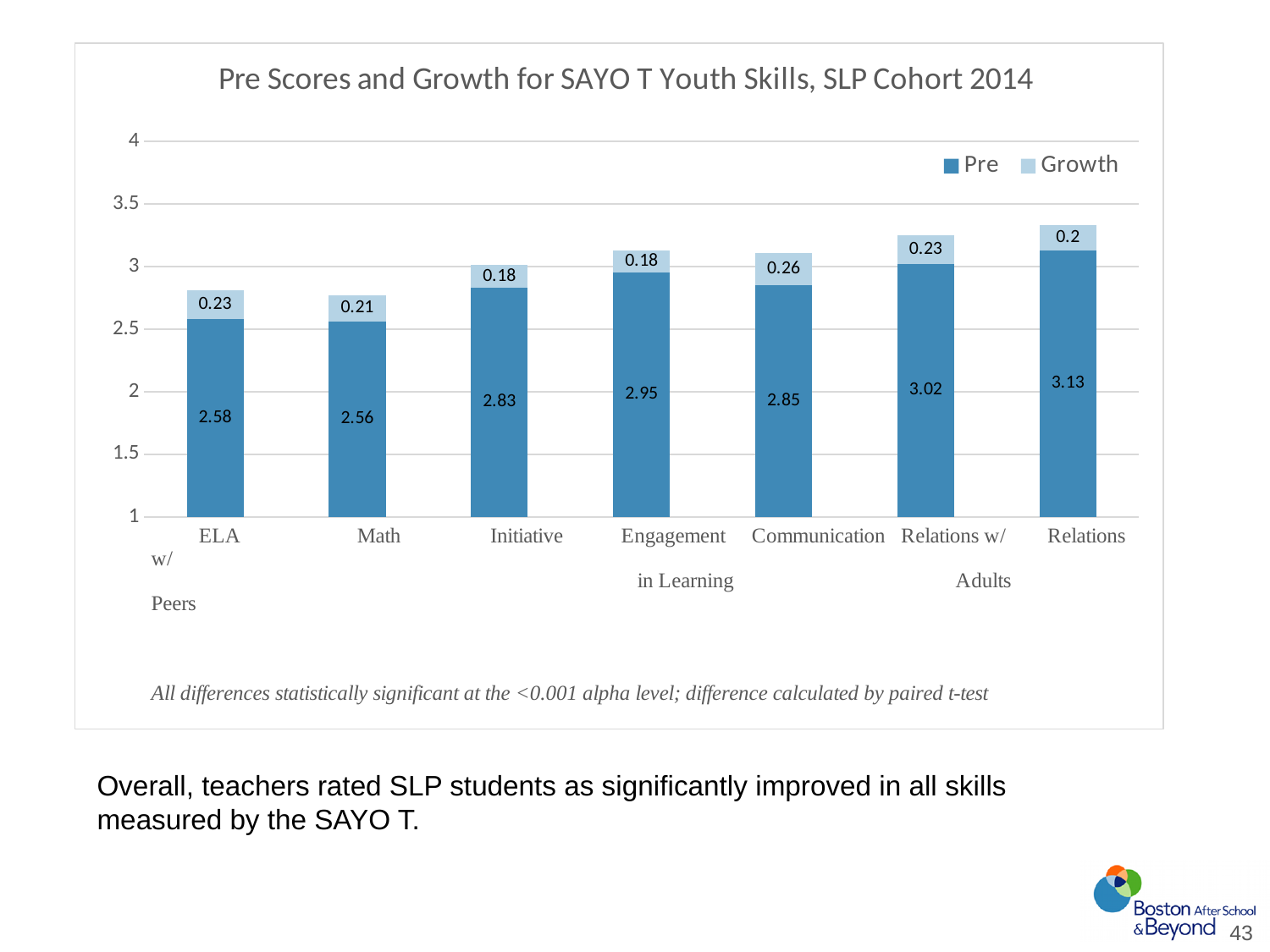
What is the Pre score for Math? 2.56 How many skill categories are shown on the x axis? 7 Which category has the largest Growth value? Communication What is the Pre score for Relations w/ Adults? 3.02 Which category has the lowest Pre score? Math What is the total height of the stacked bar for ELA (Pre plus Growth)? 2.81 What is the difference between the Pre scores for Engagement in Learning and Initiative? 0.12 Which category has the highest Pre score? Relations w/ Peers What type of chart is shown on the slide? Stacked bar chart What is the Growth value for Communication? 0.26 Which has a higher Pre score, Communication or Engagement in Learning? Engagement in Learning How many series does the legend list? 2